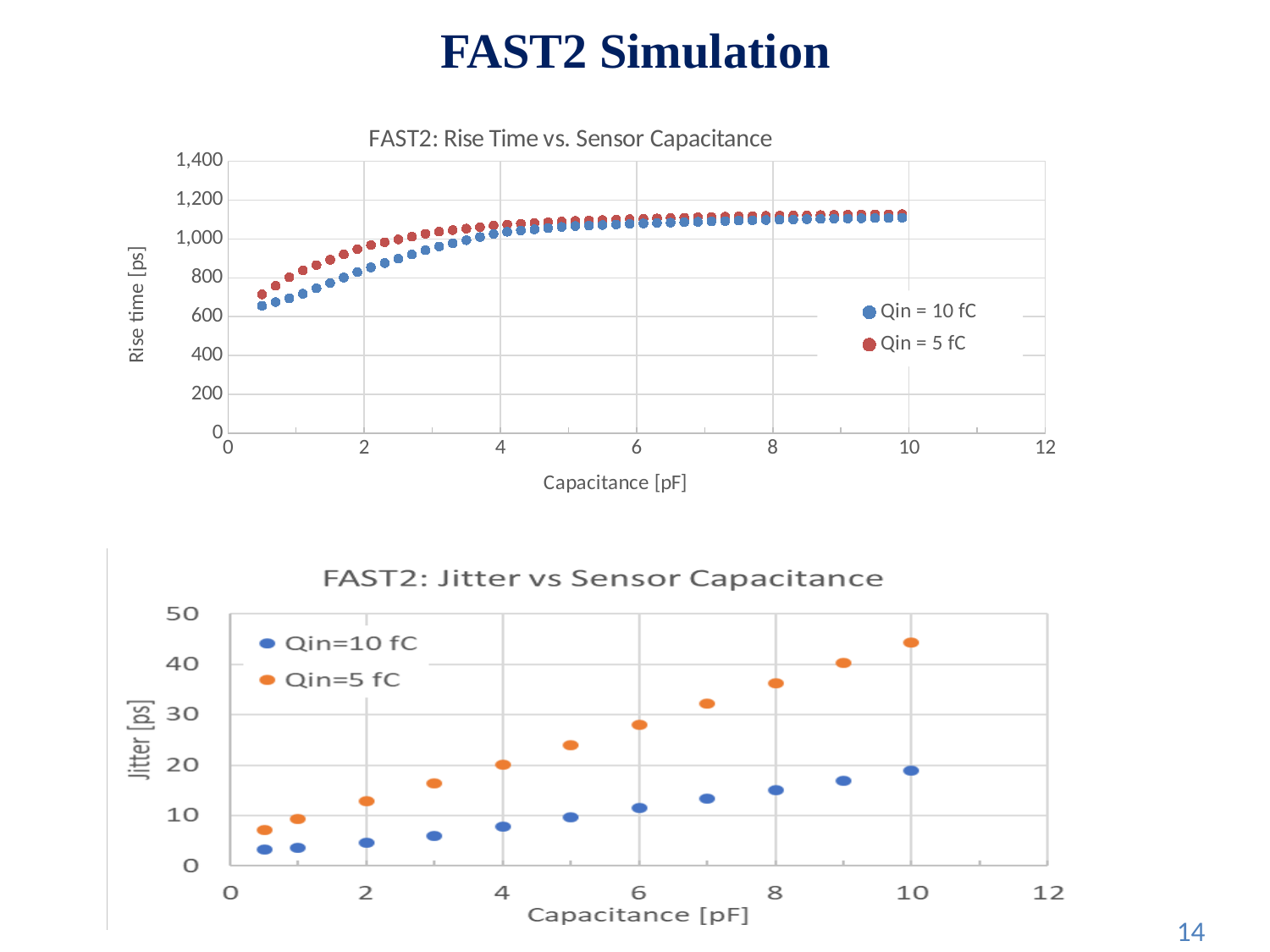
In the 'FAST2: Jitter vs Sensor Capacitance' chart, how many series does the legend list? 2 In the 'FAST2: Jitter vs Sensor Capacitance' chart, how many data points are plotted for the Qin=5 fC series? 11 In the 'FAST2: Jitter vs Sensor Capacitance' chart, is the jitter for Qin=10 fC at 4 pF greater or less than 10? less In the 'FAST2: Rise Time vs. Sensor Capacitance' chart, is the rise time for Qin = 10 fC at 2 pF greater or less than 1,000? less In the 'FAST2: Rise Time vs. Sensor Capacitance' chart, is the rise time for Qin = 5 fC at 10 pF greater or less than 1,000? greater In the 'FAST2: Rise Time vs. Sensor Capacitance' chart, what is the label of the y axis? Rise time [ps] In the 'FAST2: Rise Time vs. Sensor Capacitance' chart, how many series does the legend list? 2 In the 'FAST2: Jitter vs Sensor Capacitance' chart, at 10 pF, which series has the larger jitter, Qin=10 fC or Qin=5 fC? Qin=5 fC In the 'FAST2: Rise Time vs. Sensor Capacitance' chart, does the rise time rise or fall as capacitance increases? rise In the 'FAST2: Rise Time vs. Sensor Capacitance' chart, what kind of chart is it? scatter chart In the 'FAST2: Rise Time vs. Sensor Capacitance' chart, at 1 pF, which series has the larger rise time, Qin = 10 fC or Qin = 5 fC? Qin = 5 fC